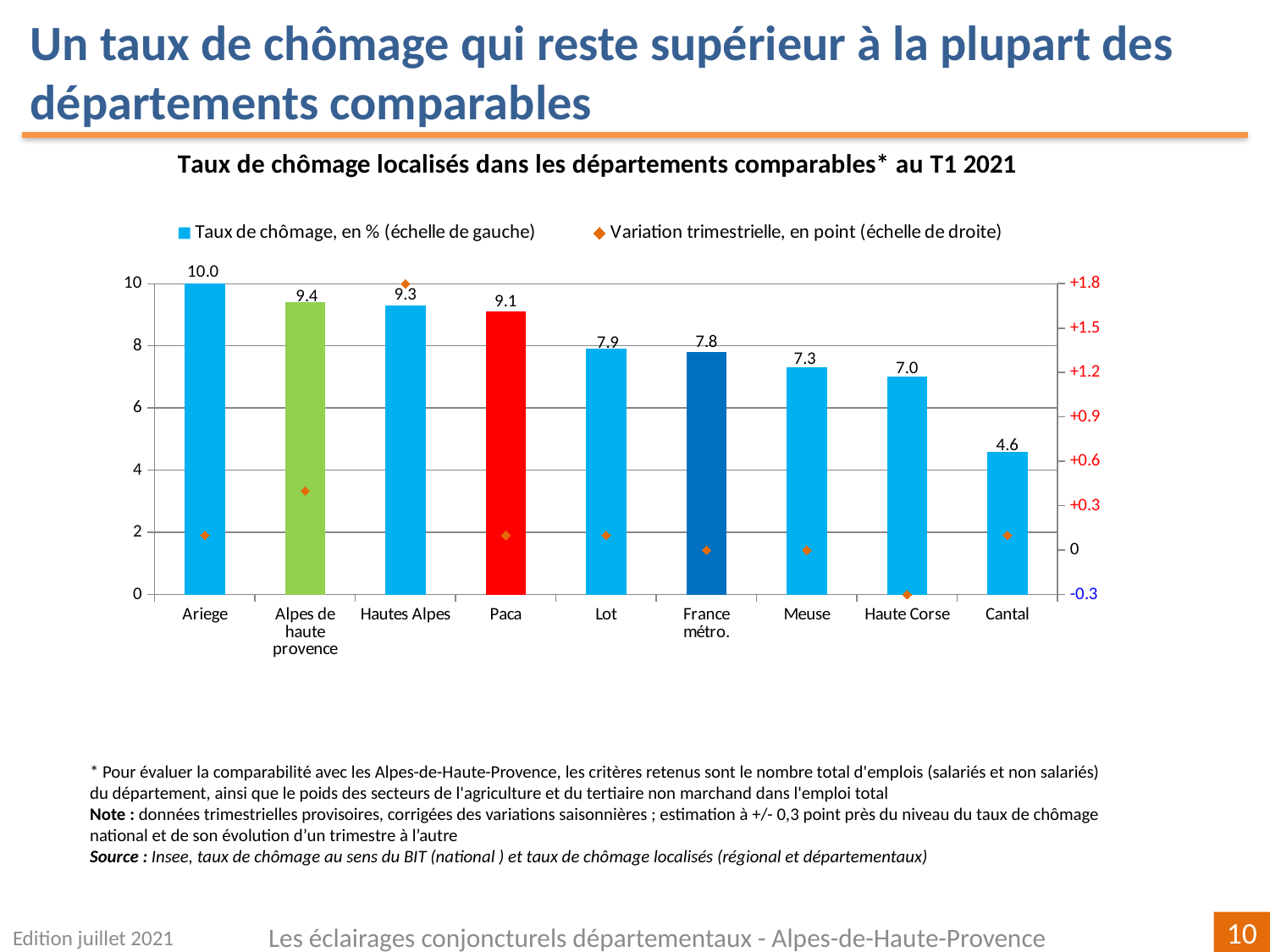
What is the unemployment rate shown for France métro.? 7.8 How many series does the chart legend list? 2 Is the quarterly variation (Variation trimestrielle) for Hautes Alpes greater or less than +1.5 points? greater How many departments/areas are shown on the x axis of the chart? 9 Which department has the lowest unemployment rate in the chart? Cantal Which has a higher unemployment rate, Lot or Meuse? Lot What is the unemployment rate (Taux de chômage, en %) shown for Ariege? 10.0 What is the difference between the unemployment rates of Alpes de haute provence and France métro.? 1.6 Which department has the highest unemployment rate in the chart? Ariege What kind of chart is used to show the unemployment rates? Bar chart What is the difference between the unemployment rates of Ariege and Cantal? 5.4 What is the unemployment rate shown for Alpes de haute provence? 9.4